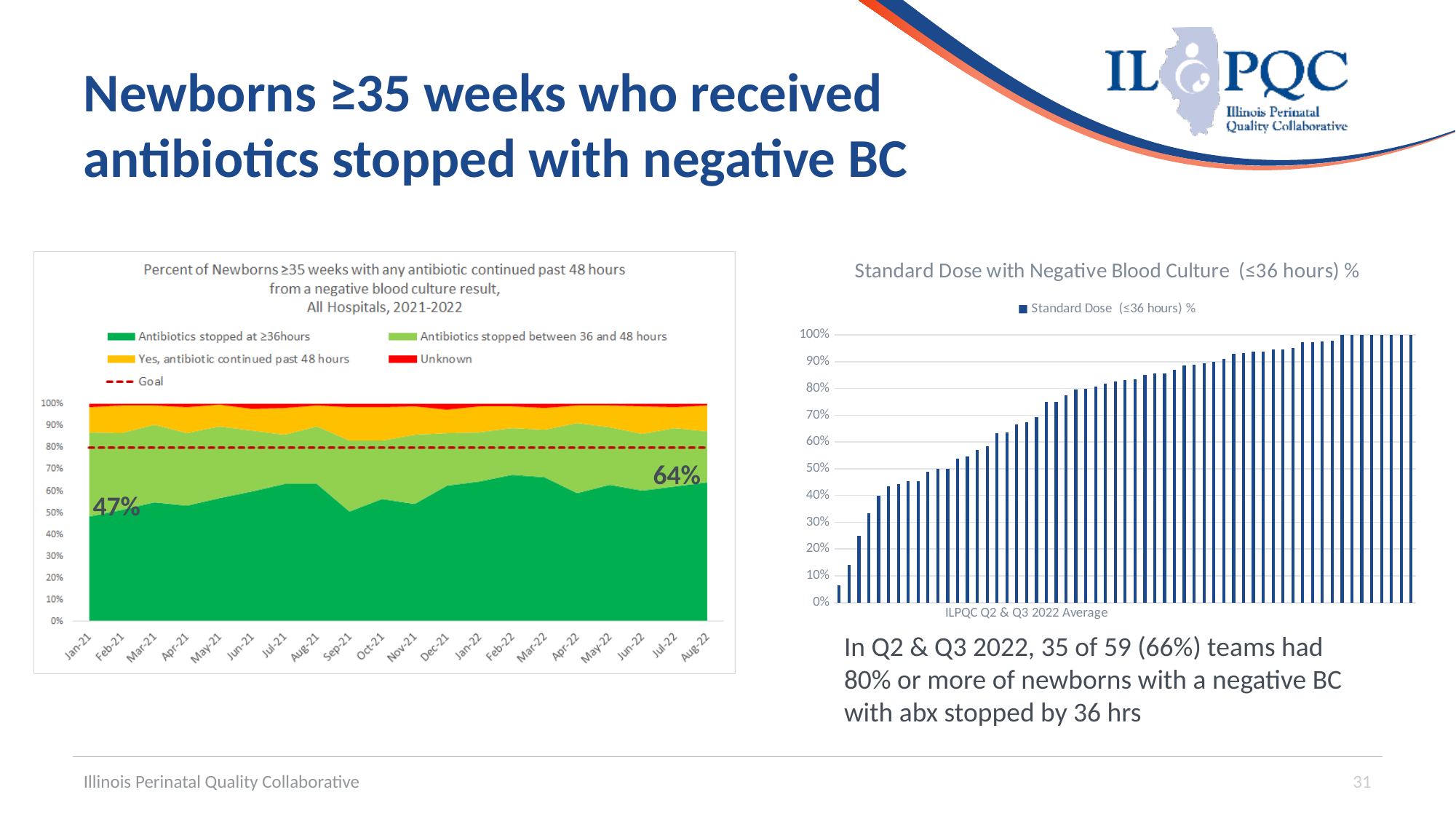
What kind of chart is the right chart, titled 'Standard Dose with Negative Blood Culture (≤36 hours) %'? Bar chart On the left chart, what is the difference between the Aug-22 value (64%) and the Jan-21 value (47%)? 17 percentage points On the left chart, what is the labelled value for antibiotics stopped at ≥36 hours in Jan-21? 47% On the right chart, how many series does the legend list? 1 On the left chart, which is larger: the labelled value for Jan-21 or for Aug-22? Aug-22 What kind of chart is the left chart? Stacked area chart On the left chart, is the Goal line greater or less than 70%? greater On the left chart, how many entries does the legend list? 5 On the left chart, what is the labelled value for antibiotics stopped at ≥36 hours in Aug-22? 64% On the left chart, how many months are shown on the x axis? 20 On the right chart, is the value of the first (leftmost) bar greater or less than 10%? less On the right chart, do the bar values rise or fall from left to right? Rise